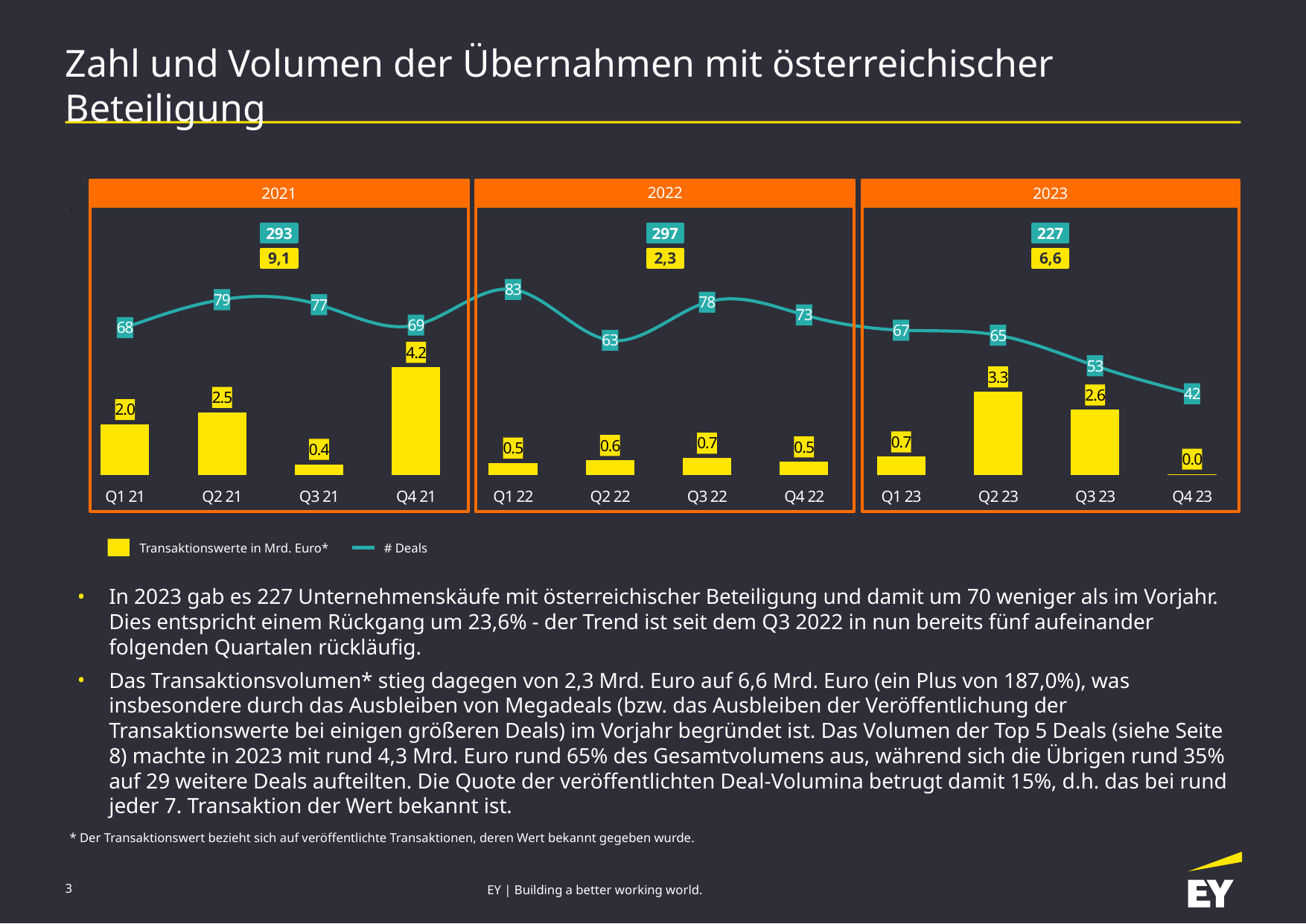
Which quarter has the lowest number of deals (# Deals)? Q4 23 What is the Transaktionswert in Mrd. Euro for Q4 21? 4.2 What kind of chart is shown on the slide? Combined bar and line chart What are the two legend entries of the chart? Transaktionswerte in Mrd. Euro* and # Deals Which quarter has the highest number of deals (# Deals)? Q1 22 Does the number of deals (# Deals) rise or fall from Q1 23 to Q4 23? Fall How many quarters are shown on the x axis of the chart? 12 How many series does the legend list? 2 Which quarter has the larger Transaktionswert, Q2 21 or Q3 23? Q3 23 What is the difference between the Transaktionswerte of Q2 23 and Q3 23? 0.7 What is the total number of deals shown for the year 2023? 227 How many deals (# Deals) are shown for Q1 22? 83